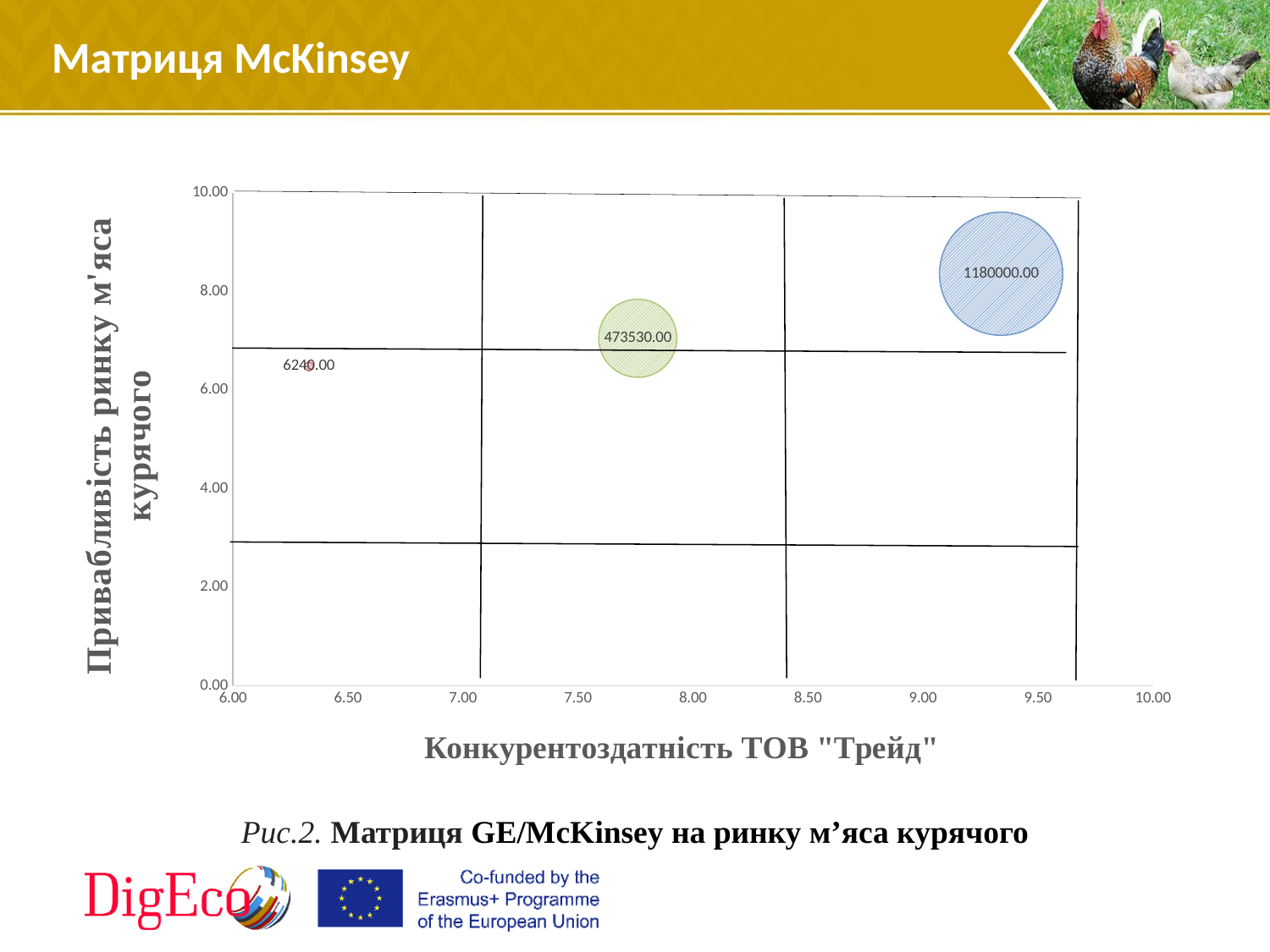
Is the horizontal-axis position of the bubble labelled 6240.00 greater or less than 6.50? less What kind of chart is shown on the slide? bubble chart What is the data label of the largest bubble on the chart? 1180000.00 Which bubble has the larger label value: the one labelled 473530.00 or the one labelled 6240.00? 473530.00 What is the title of the horizontal axis of the chart? Конкурентоздатність ТОВ "Трейд" What is the data label of the smallest bubble on the chart? 6240.00 What is the difference between the bubble labelled 473530.00 and the bubble labelled 6240.00? 467290.00 Is the vertical-axis position of the bubble labelled 1180000.00 greater or less than 8.00? greater What is the maximum value shown on the vertical axis of the chart? 10.00 What is the data label of the bubble located near x = 7.75 on the chart? 473530.00 What is the difference between the bubble labelled 1180000.00 and the bubble labelled 473530.00? 706470.00 How many bubbles are plotted on the chart? 3